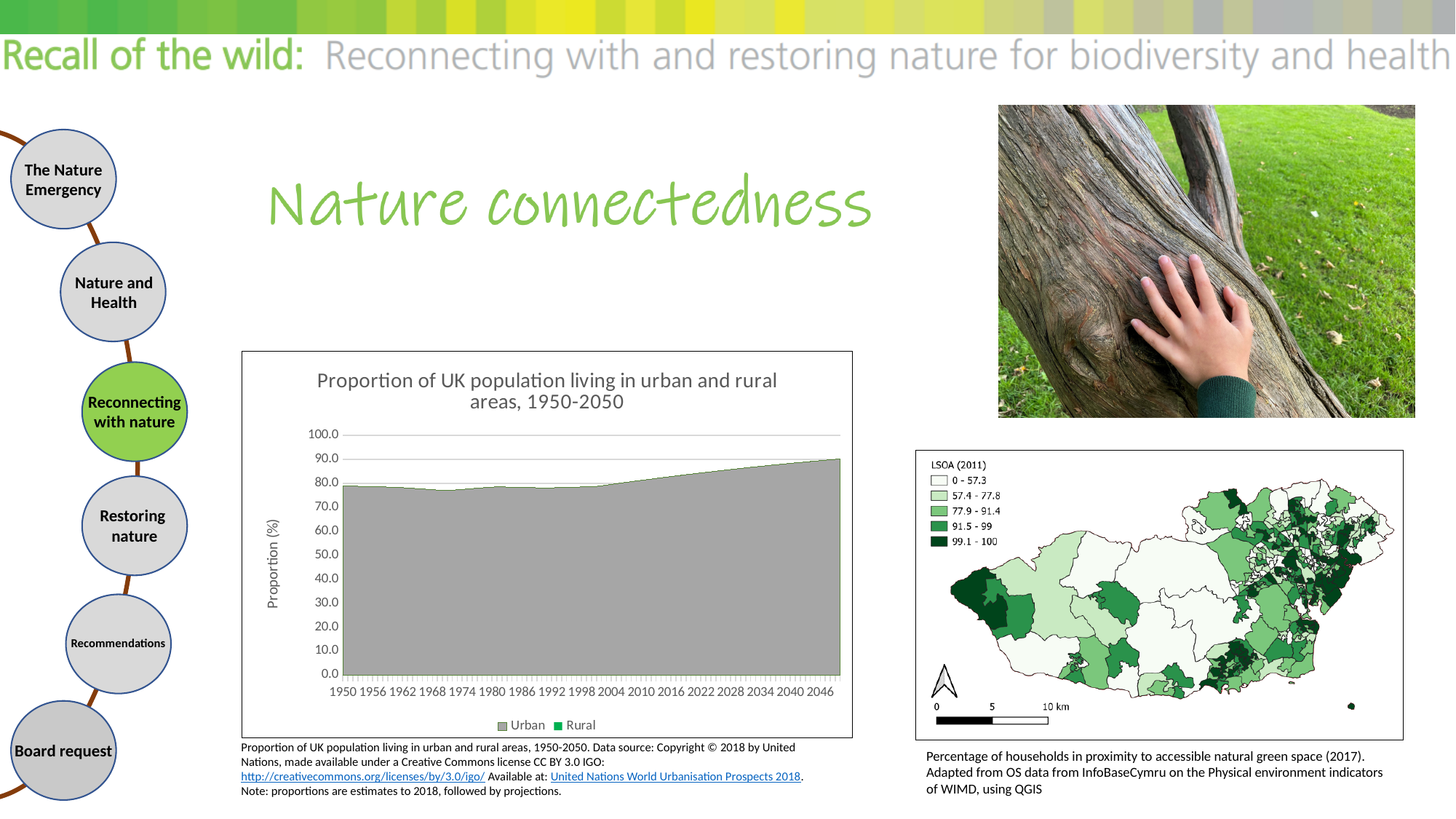
Which series has the larger proportion in 2046, Urban or Rural? Urban Is the Urban proportion in 1950 greater or less than 70.0? greater Does the Urban proportion rise or fall overall from 1950 to 2050? Rise Is the Rural proportion in 2046 greater or less than 20.0? less What kind of chart is shown on the slide? Area chart How many year labels are shown on the x axis? 17 How many series does the chart's legend list? 2 Which series are listed in the chart's legend? Urban and Rural Is the Urban proportion in 2046 greater or less than 80.0? greater What is the highest value shown on the y axis? 100.0 What is the title of the chart? Proportion of UK population living in urban and rural areas, 1950-2050 Does the Rural proportion rise or fall overall from 1950 to 2050? Fall